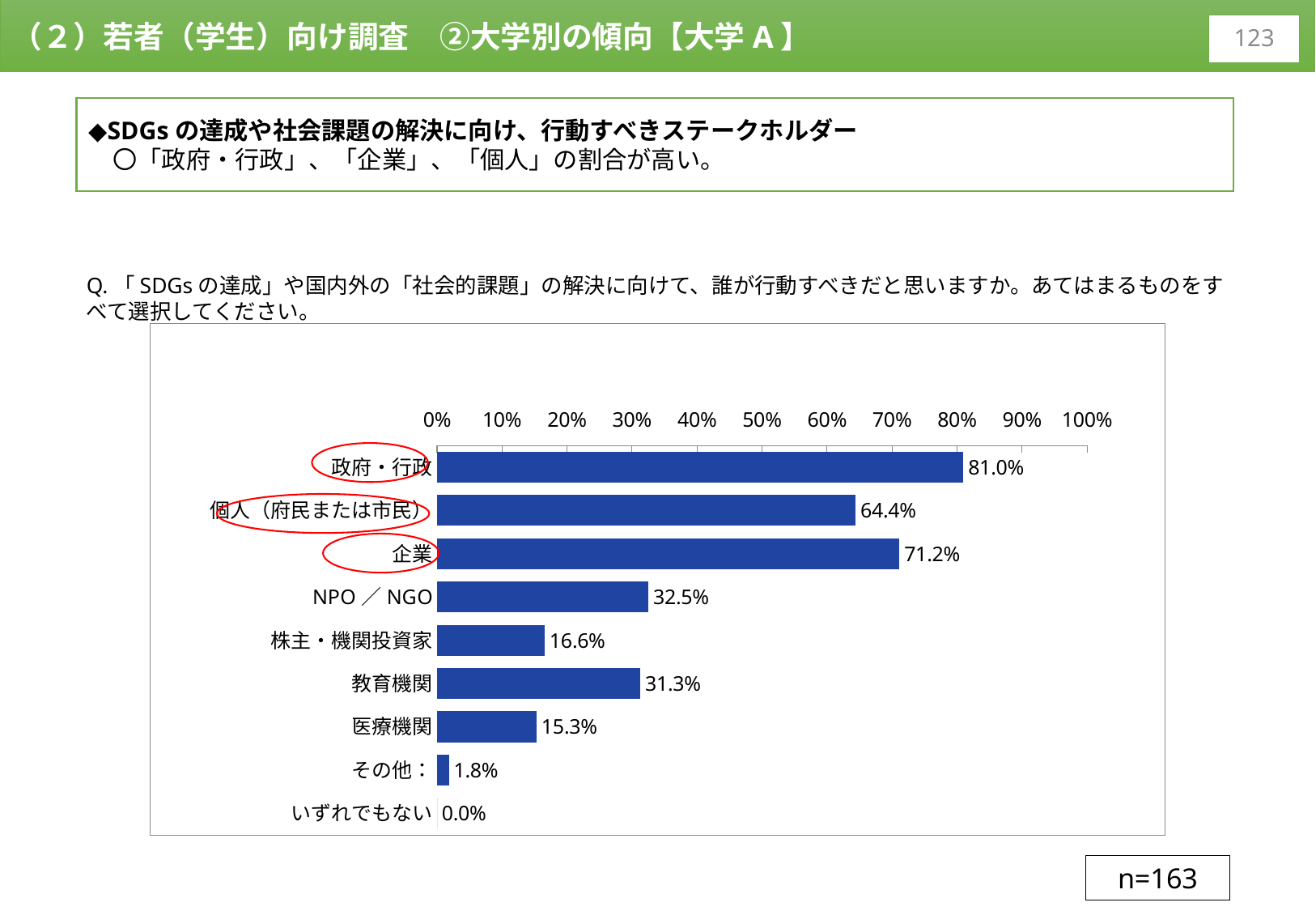
How many categories are shown in the chart? 9 What is the difference between the values for 政府・行政 and 企業? 9.8% What is the value for 医療機関? 15.3% What is the value for NPO／NGO? 32.5% Which is larger, the value for 個人（府民または市民） or the value for 企業? 企業 What kind of chart is shown on the slide? bar chart What is the sample size (n) shown on the slide? n=163 Which category has the highest value? 政府・行政 Is the value for 教育機関 greater or less than 40%? less Which category has the lowest value? いずれでもない What is the value for 政府・行政? 81.0% What is the value for 企業? 71.2%